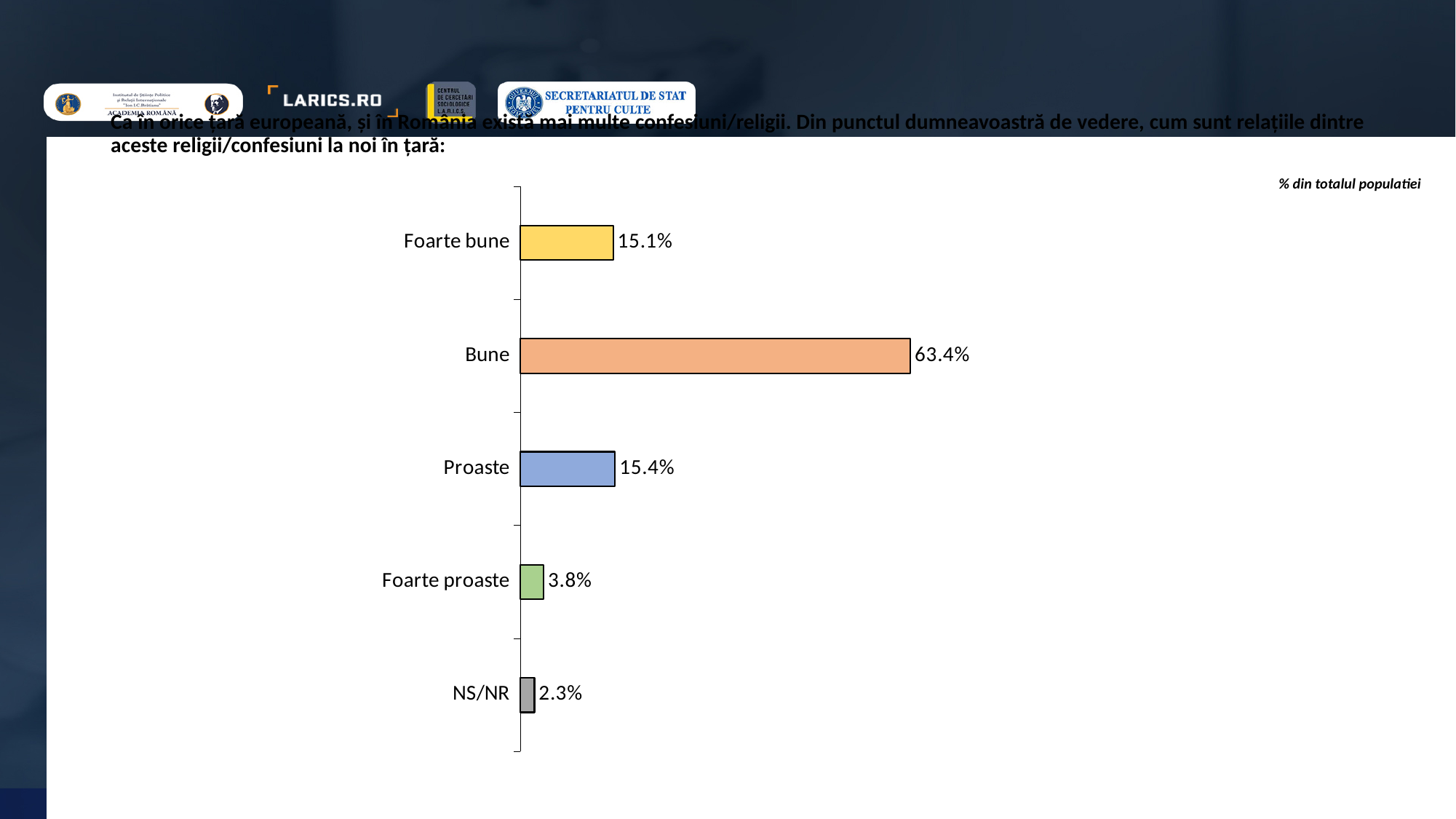
What kind of chart is shown on the slide? Bar chart Which category has the lowest value? NS/NR How many categories are shown in the chart? 5 What is the value shown for "NS/NR"? 2.3% Which category has the highest value? Bune Which is larger, the value for "Foarte bune" or the value for "Foarte proaste"? Foarte bune What percentage of respondents answered "Bune"? 63.4% What is the value shown for "Proaste"? 15.4% What is the value shown for "Foarte proaste"? 3.8% What is the value shown for "Foarte bune"? 15.1% What is the difference between the values for "Foarte proaste" and "NS/NR"? 1.5% What is the difference between the values for "Bune" and "Proaste"? 48.0%